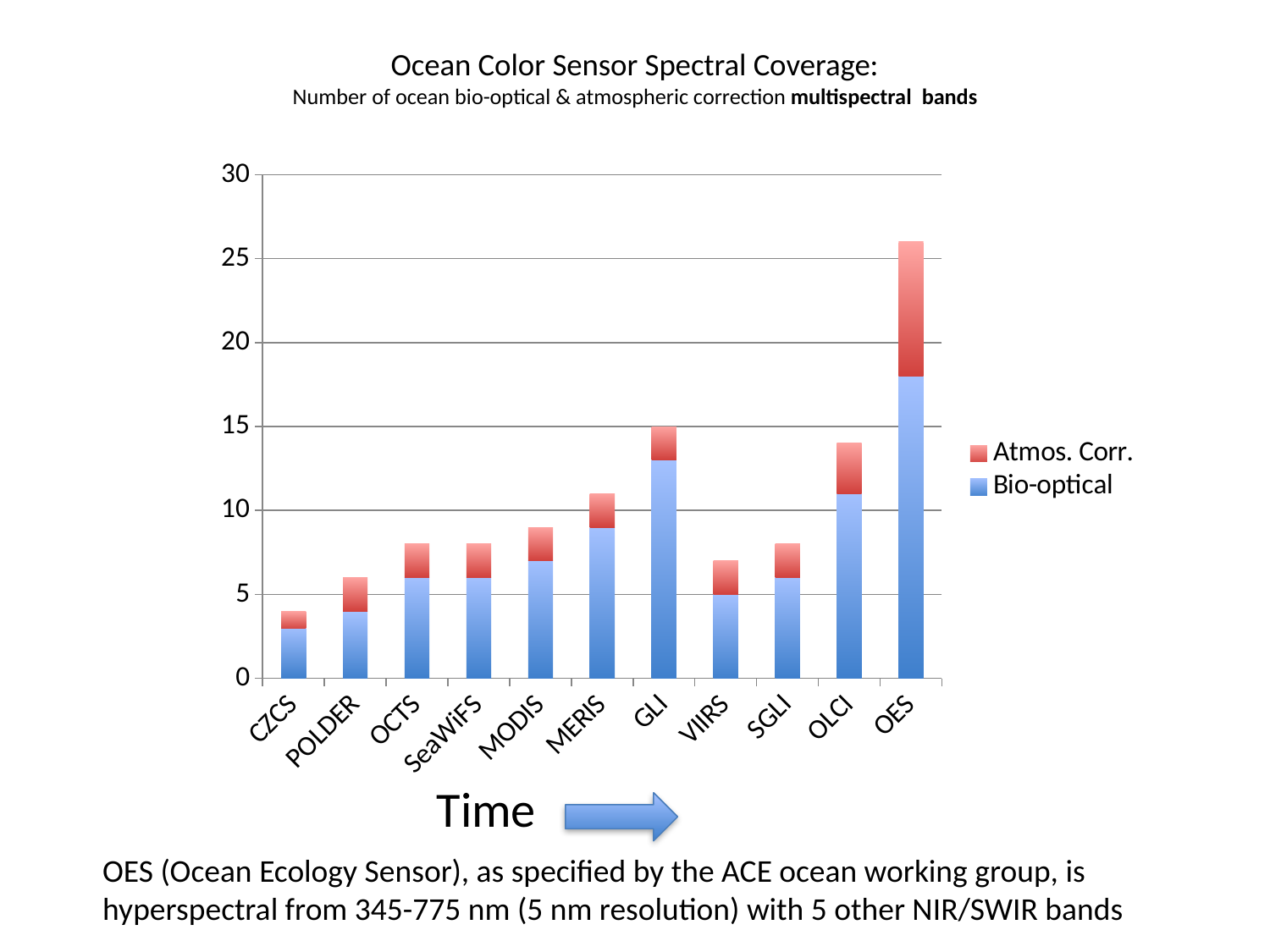
Is the total value for GLI greater or less than 10? greater Which has a larger total number of bands, GLI or MERIS? GLI What label with an arrow appears beneath the x axis of the chart? Time How many series does the chart legend list? 2 Is the total value for VIIRS greater or less than 10? less Which sensor has the lowest total number of bands in the chart? CZCS What kind of chart is shown on the slide? Stacked bar chart Is the total value for OES greater or less than 20? greater Which series is shown in red in the chart? Atmos. Corr. How many sensors (categories) are shown on the x axis of the chart? 11 Which sensor has the highest total number of bands in the chart? OES